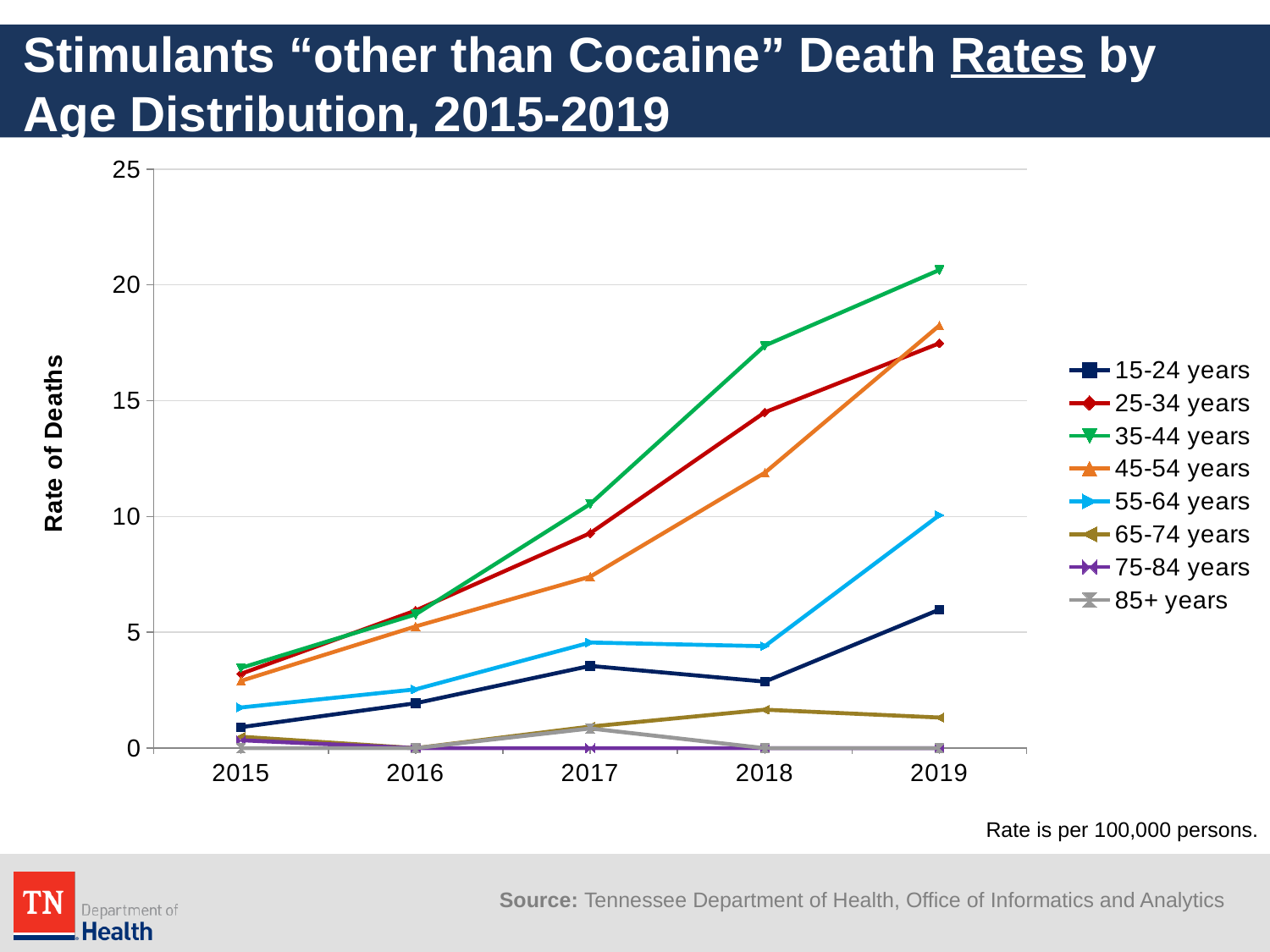
Is the value for 55-64 years in 2019 greater or less than 5? greater How many years are plotted along the x axis? 5 What is the label on the y axis? Rate of Deaths Which age group has the highest death rate in 2017? 35-44 years What kind of chart is shown on the slide? line chart In 2018, which is larger: the value for 25-34 years or the value for 45-54 years? 25-34 years Does the death rate for 35-44 years rise or fall from 2015 to 2019? rises Is the value for 25-34 years in 2017 greater or less than 10? less How many series does the legend list? 8 Is the value for 35-44 years in 2018 greater or less than 15? greater Which age group has the highest death rate in 2019? 35-44 years